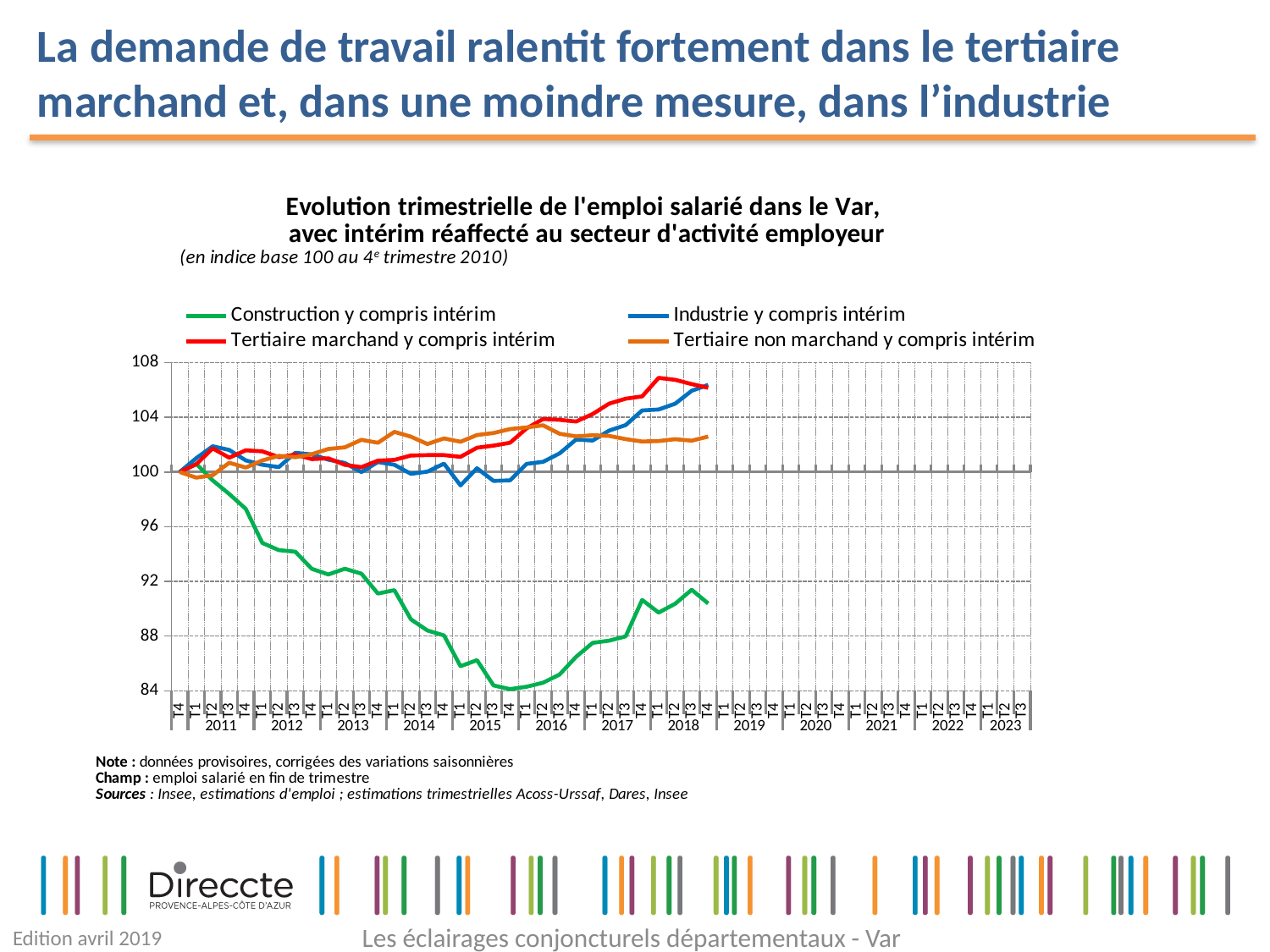
Is the value for Construction y compris intérim at T4 2015 greater or less than 88? less How many series does the legend list? 4 Is the value for Construction y compris intérim at T4 2018 greater or less than 92? less What colour is the line for Construction y compris intérim? green Does the Construction y compris intérim series rise or fall between T4 2010 and T4 2015? fall Which series has the highest value at T1 2018? Tertiaire marchand y compris intérim Which series has the lowest value at T4 2018? Construction y compris intérim What kind of chart is shown on the slide? line chart Is the value for Tertiaire marchand y compris intérim at T4 2018 greater or less than 104? greater What is the index value of all series at T4 2010? 100 Does the Industrie y compris intérim series rise or fall between T1 2016 and T4 2018? rise